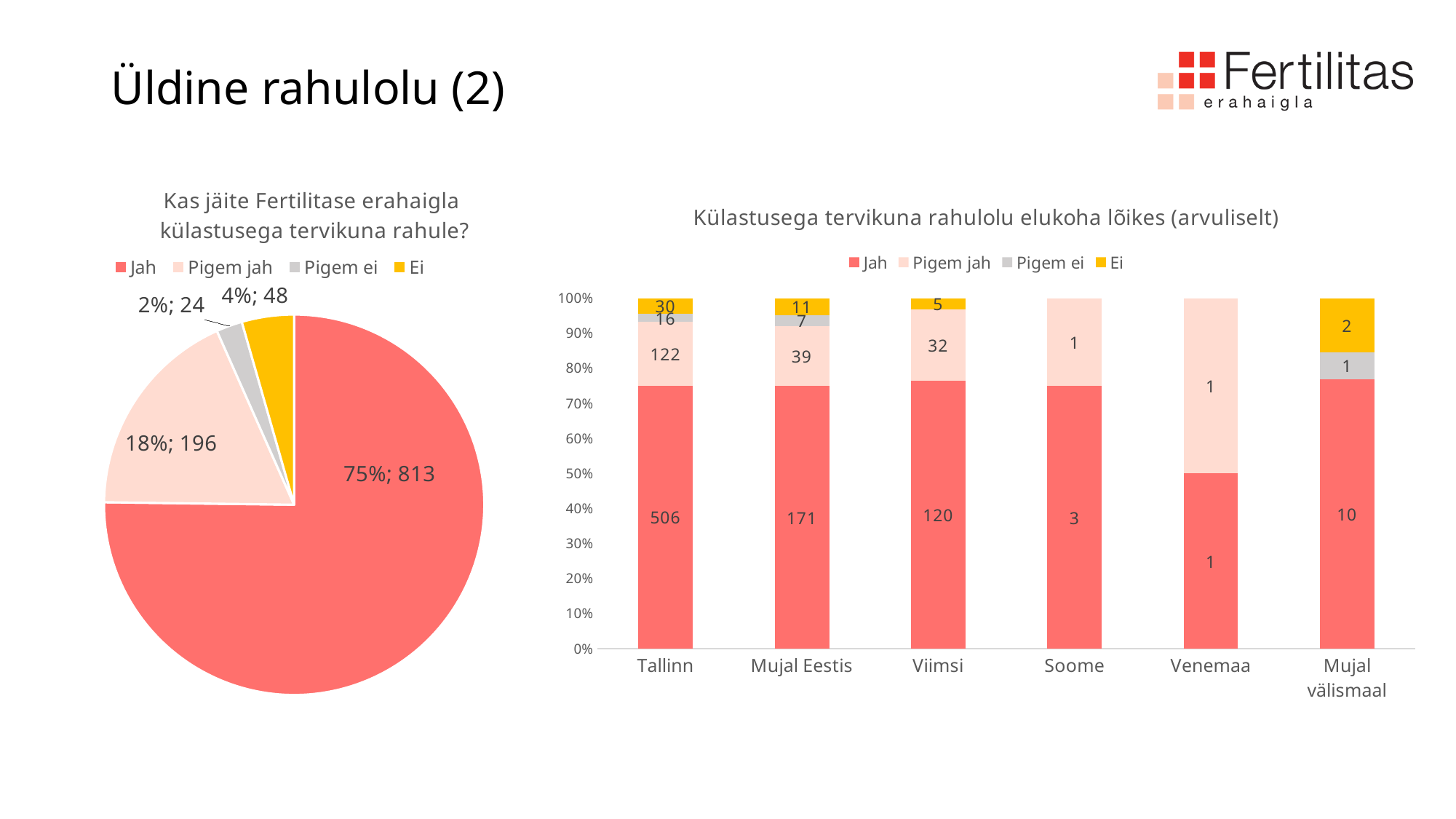
In the pie chart on the left, how many more respondents answered "Ei" than "Pigem ei"? 24 In the pie chart on the left, which answer has the smallest slice? Pigem ei In the pie chart on the left, what share of respondents answered "Jah"? 75% In the chart "Külastusega tervikuna rahulolu elukoha lõikes (arvuliselt)", what is the "Jah" value for Tallinn? 506 In the chart "Külastusega tervikuna rahulolu elukoha lõikes (arvuliselt)", what is the "Pigem jah" value for Mujal Eestis? 39 In the chart "Külastusega tervikuna rahulolu elukoha lõikes (arvuliselt)", what is the total number of respondents for Mujal välismaal? 13 In the chart "Külastusega tervikuna rahulolu elukoha lõikes (arvuliselt)", how many location categories are shown on the x axis? 6 In the chart "Külastusega tervikuna rahulolu elukoha lõikes (arvuliselt)", how many series does the legend list? 4 In the chart "Külastusega tervikuna rahulolu elukoha lõikes (arvuliselt)", which has the larger "Ei" value, Tallinn or Mujal Eestis? Tallinn What kind of chart is the one on the right of the slide? Stacked bar chart In the chart "Külastusega tervikuna rahulolu elukoha lõikes (arvuliselt)", what is the total number of respondents for Tallinn? 674 In the pie chart on the left, how many respondents answered "Pigem jah"? 196